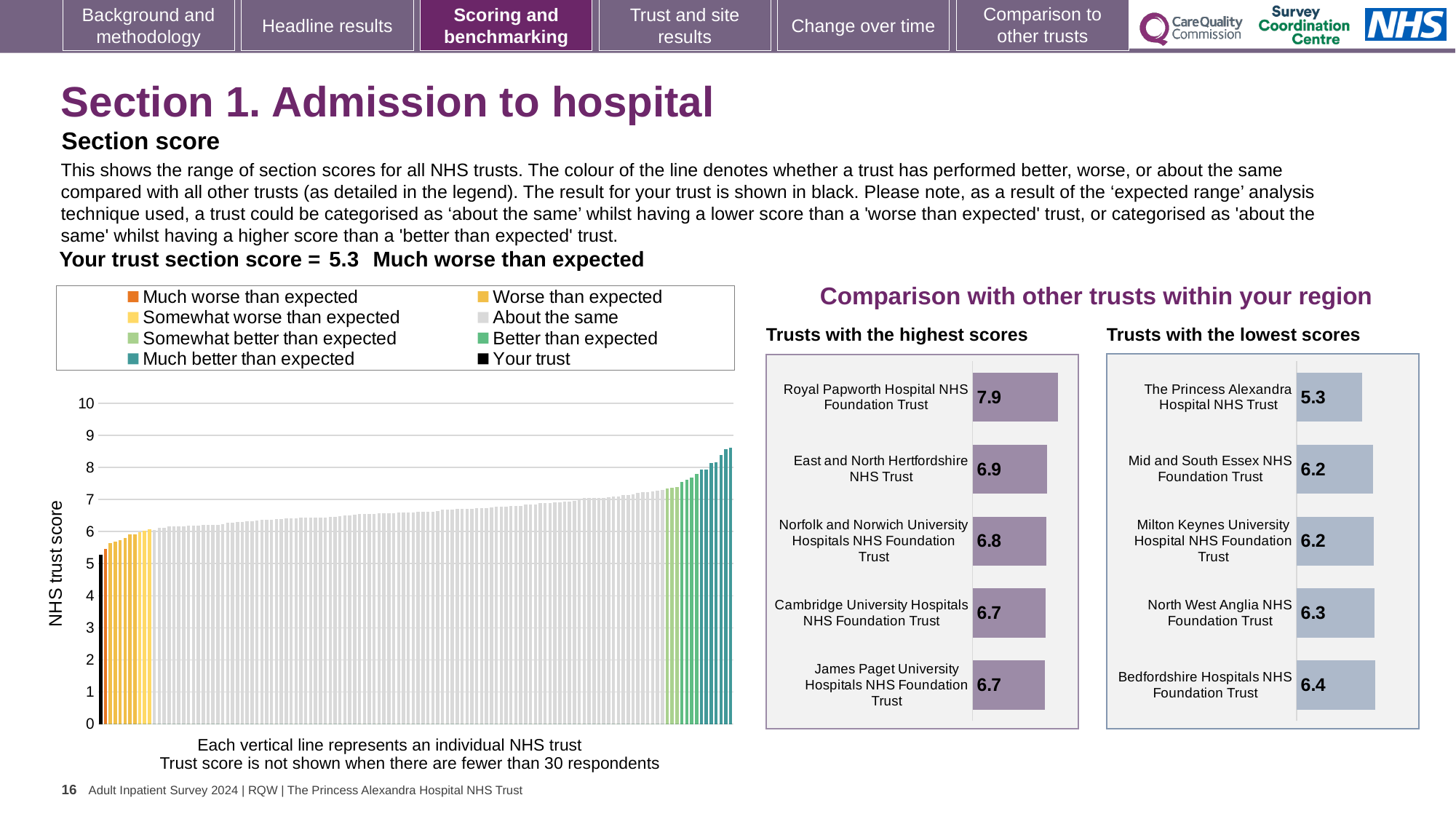
In the 'Trusts with the highest scores' chart, what is the score for Royal Papworth Hospital NHS Foundation Trust? 7.9 In the large chart on the left showing NHS trust scores, is the value for the black 'Your trust' bar greater or less than 6? less In the 'Trusts with the highest scores' chart, what is the difference between the scores of Royal Papworth Hospital NHS Foundation Trust and East and North Hertfordshire NHS Trust? 1.0 In the 'Trusts with the highest scores' chart, how many trusts are shown? 5 In the 'Trusts with the lowest scores' chart, what is the score for Mid and South Essex NHS Foundation Trust? 6.2 In the 'Trusts with the lowest scores' chart, which trust has the lowest score? The Princess Alexandra Hospital NHS Trust In the large chart on the left showing NHS trust scores, how many entries does the legend list? 8 In the large chart on the left showing NHS trust scores, do the bar values rise or fall from left to right along the x axis? Rise In the 'Trusts with the lowest scores' chart, which has the higher score: Bedfordshire Hospitals NHS Foundation Trust or Mid and South Essex NHS Foundation Trust? Bedfordshire Hospitals NHS Foundation Trust In the large chart on the left showing NHS trust scores, what kind of chart is it? Bar chart In the 'Trusts with the highest scores' chart, which trust has the highest score? Royal Papworth Hospital NHS Foundation Trust In the 'Trusts with the lowest scores' chart, what is the difference between the scores of Bedfordshire Hospitals NHS Foundation Trust and The Princess Alexandra Hospital NHS Trust? 1.1